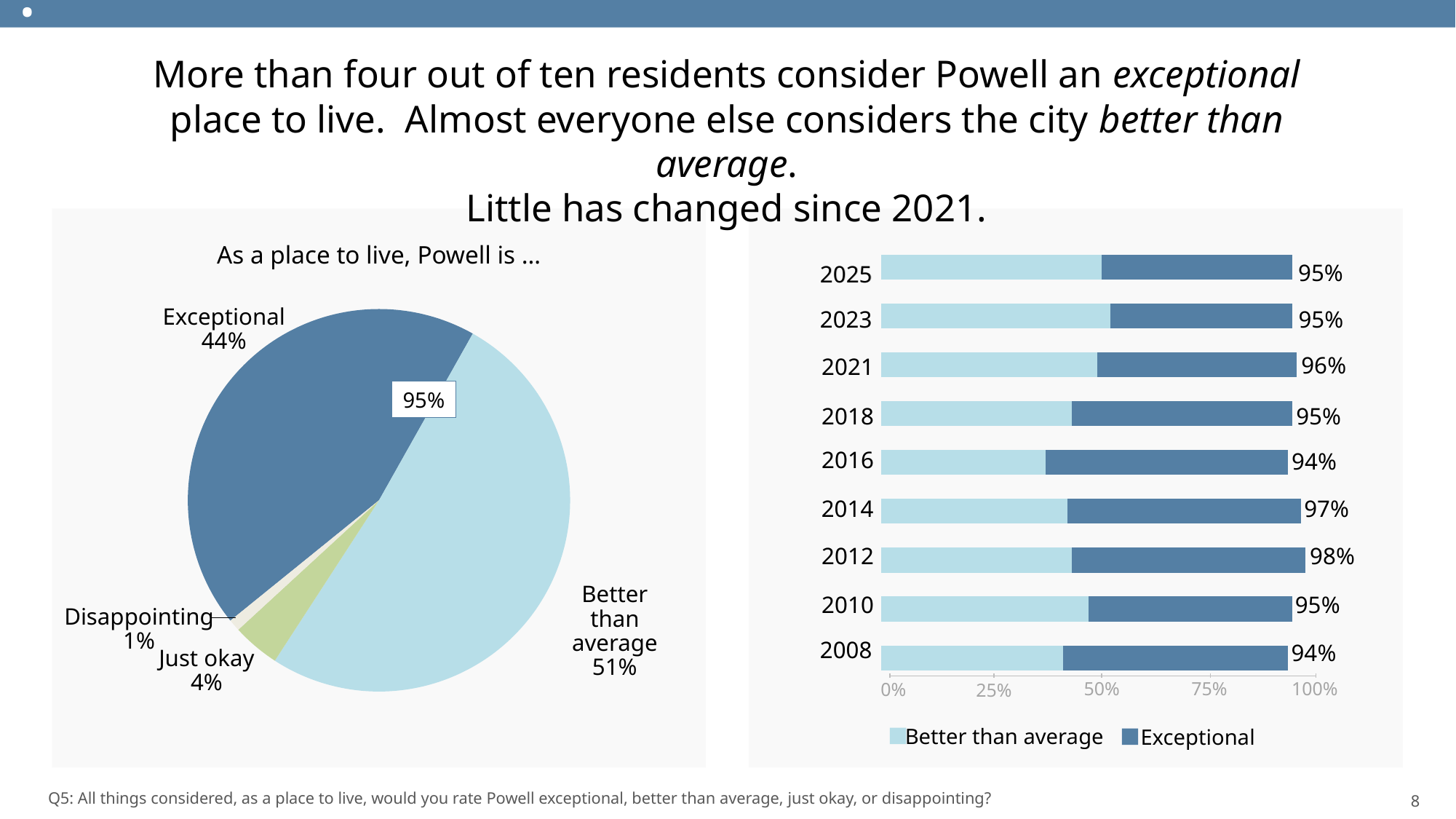
In the stacked bar chart on the right, which year has the highest total? 2012 In the stacked bar chart on the right, is the total for 2014 or 2016 larger? 2014 In the pie chart on the left, what share of residents rate Powell as Better than average? 51% In the stacked bar chart on the right, is the Better than average value for 2016 greater or less than 50%? less In the pie chart on the left, which category has the smallest share? Disappointing In the pie chart on the left, how many categories are shown? 4 In the stacked bar chart on the right, how many years are shown? 9 In the pie chart on the left, which category has the largest share? Better than average In the stacked bar chart on the right, how many series does the legend list? 2 In the pie chart on the left, what is the difference between the Better than average share and the Exceptional share? 7 percentage points In the pie chart titled "As a place to live, Powell is ...", what share of residents rate Powell as Exceptional? 44% In the stacked bar chart on the right, what is the total labelled for 2012? 98%